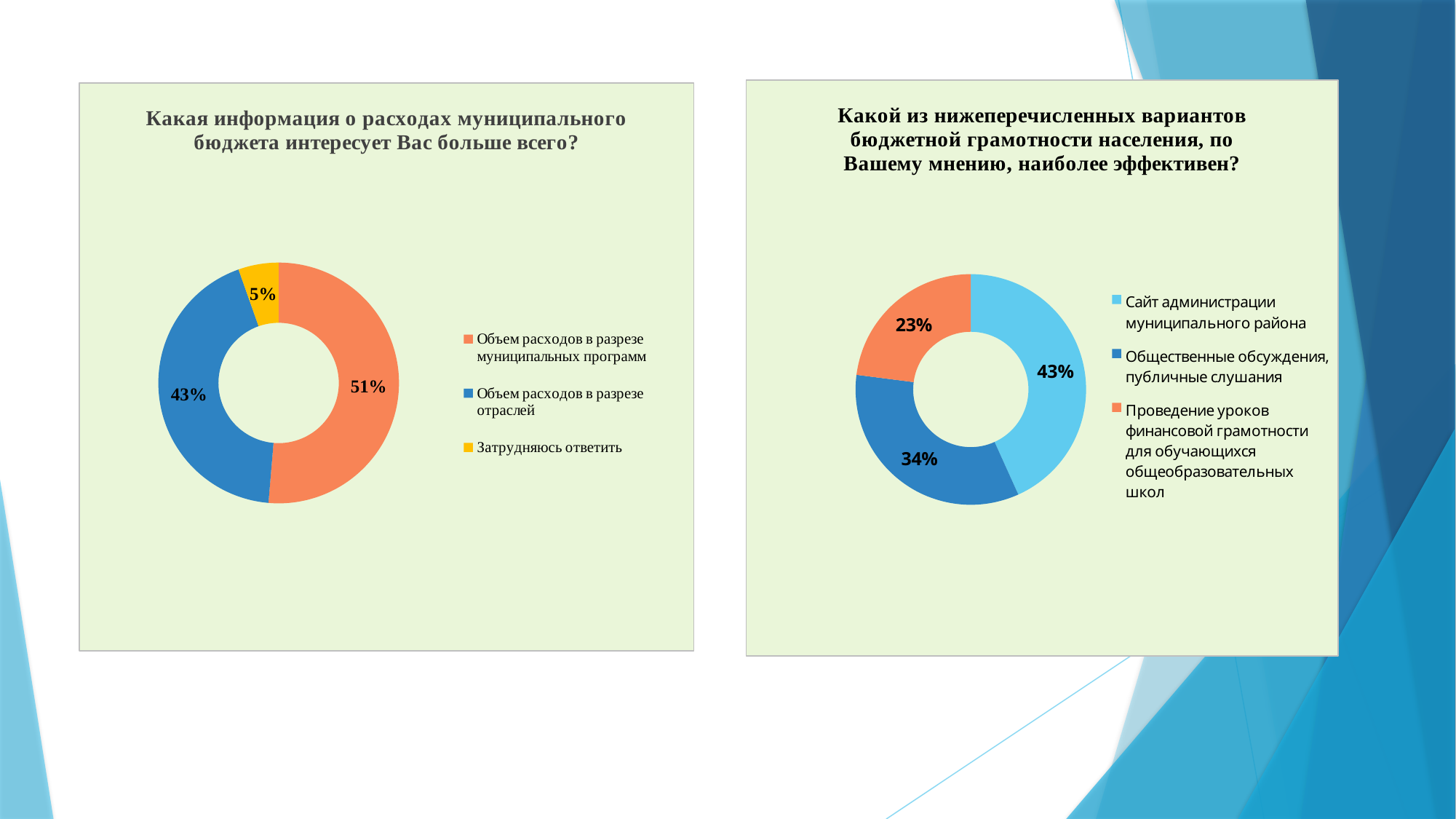
In the left chart, what percentage is shown for "Затрудняюсь ответить"? 5% In the left chart, which category has the largest share? Объем расходов в разрезе муниципальных программ In the right chart, what percentage is shown for "Общественные обсуждения, публичные слушания"? 34% In the left chart, which category has the smallest share? Затрудняюсь ответить In the right chart, which is larger: the share for "Общественные обсуждения, публичные слушания" or for "Проведение уроков финансовой грамотности для обучающихся общеобразовательных школ"? Общественные обсуждения, публичные слушания In the left chart, what is the difference between the shares for "Объем расходов в разрезе муниципальных программ" and "Объем расходов в разрезе отраслей"? 8% What type of chart is the right chart? Doughnut chart How many categories does the left chart show? 3 In the right chart, which option has the smallest share? Проведение уроков финансовой грамотности для обучающихся общеобразовательных школ In the right chart, what is the difference between the shares for "Сайт администрации муниципального района" and "Проведение уроков финансовой грамотности для обучающихся общеобразовательных школ"? 20% In the right chart, what share is shown for "Сайт администрации муниципального района"? 43% In the left chart, what share of respondents chose "Объем расходов в разрезе муниципальных программ"? 51%